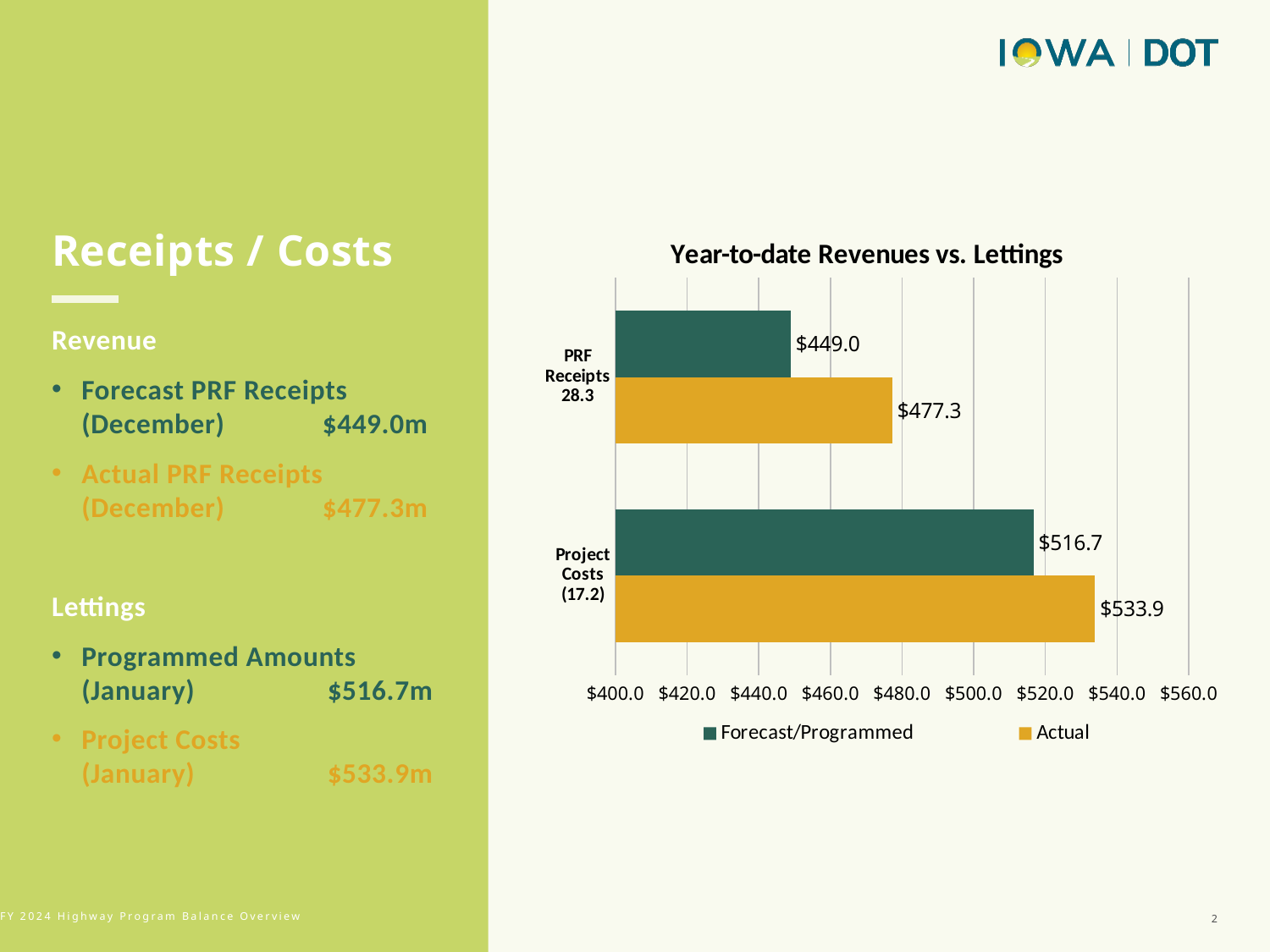
What is the title of the chart? Year-to-date Revenues vs. Lettings Which bar in the chart has the highest value? Actual Project Costs How many series does the legend list? 2 What is the Forecast/Programmed value for Project Costs? $516.7 What is the difference between the Actual and Forecast/Programmed values for Project Costs? $17.2 Which is larger for Project Costs: the Forecast/Programmed value or the Actual value? Actual What is the difference between the Actual and Forecast/Programmed values for PRF Receipts? $28.3 Which bar in the chart has the lowest value? Forecast/Programmed PRF Receipts What type of chart is shown on the slide? Bar chart What is the Actual value for PRF Receipts? $477.3 What is the Actual value for Project Costs? $533.9 What is the Forecast/Programmed value for PRF Receipts? $449.0